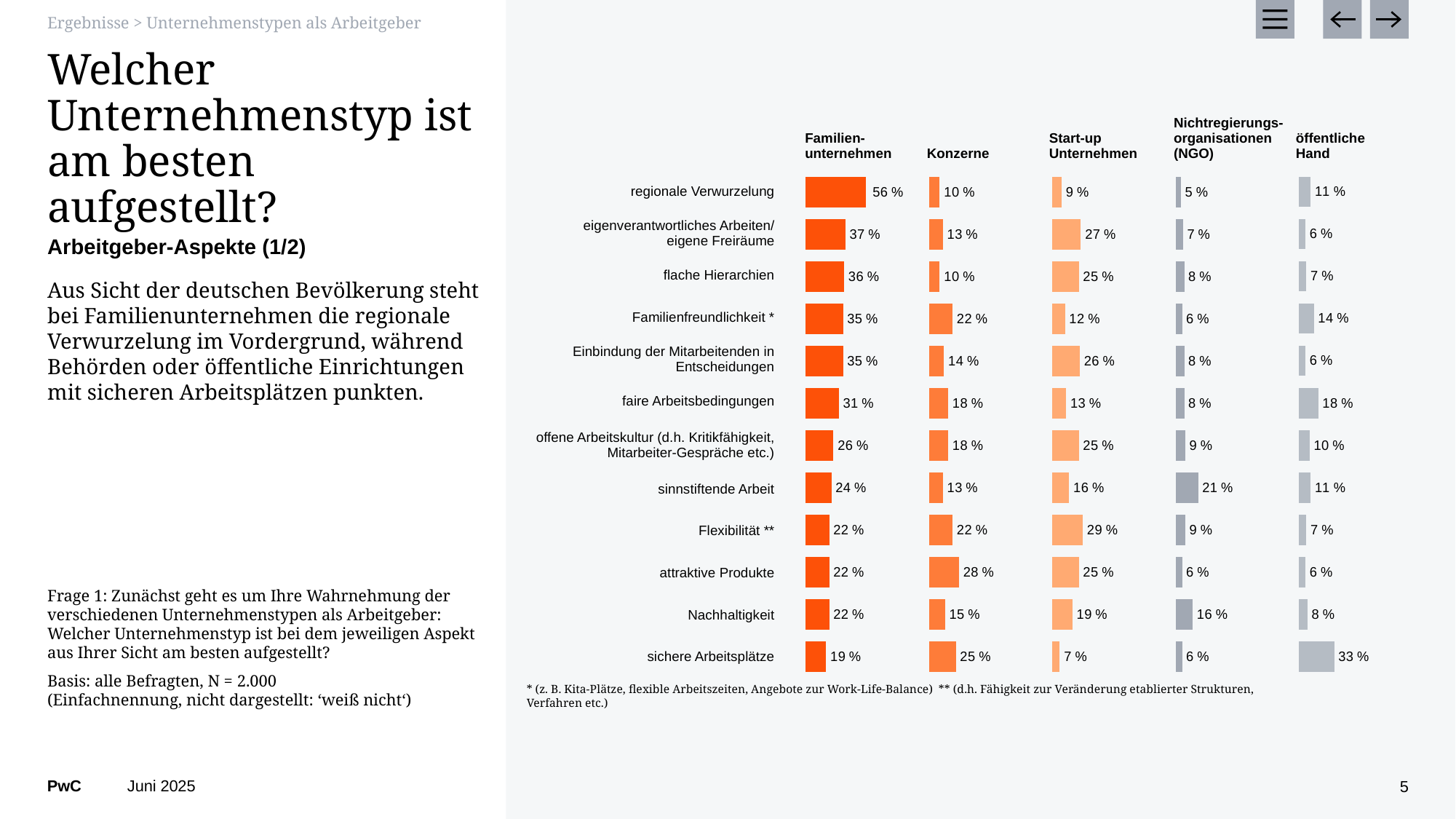
Which aspect has the highest value in the Familienunternehmen column? regionale Verwurzelung For 'sichere Arbeitsplätze', which is higher: Familienunternehmen or Konzerne? Konzerne For 'attraktive Produkte', which is higher: Konzerne or Start-up Unternehmen? Konzerne How many company types (columns) are compared in the chart? 5 What value is shown for Start-up Unternehmen on 'Flexibilität **'? 29 % Which aspect has the highest value in the Nichtregierungsorganisationen (NGO) column? sinnstiftende Arbeit Which aspect has the lowest value in the Familienunternehmen column? sichere Arbeitsplätze What is the difference between Familienunternehmen and Konzerne on 'regionale Verwurzelung'? 46 % How many aspects (rows) are shown in the chart? 12 What percentage of respondents see Familienunternehmen as best positioned for 'regionale Verwurzelung'? 56 % What type of chart is used on this slide? bar chart What value is shown for 'öffentliche Hand' on 'sichere Arbeitsplätze'? 33 %